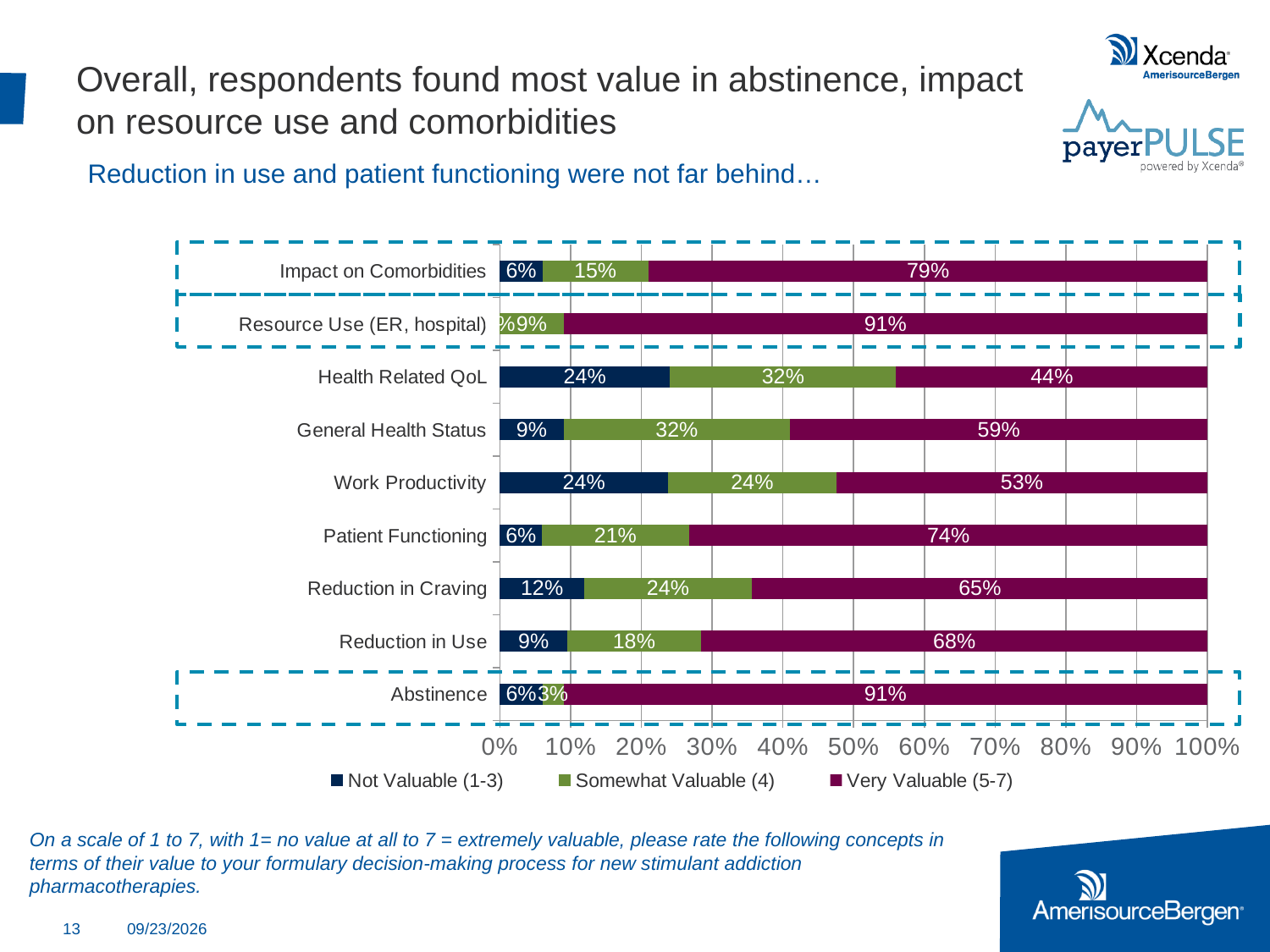
How many series does the legend list? 3 What type of chart is shown on the slide? Stacked bar chart How many concepts are shown in the chart? 9 What percentage of respondents rated Abstinence as Very Valuable (5-7)? 91% What percentage of respondents rated Patient Functioning as Somewhat Valuable (4)? 21% What percentage of respondents rated Impact on Comorbidities as Very Valuable (5-7)? 79% Which has a higher Very Valuable (5-7) percentage: General Health Status or Work Productivity? General Health Status What percentage of respondents rated Health Related QoL as Not Valuable (1-3)? 24% What is the difference in Very Valuable (5-7) percentage between Reduction in Use and Reduction in Craving? 3 percentage points Is the Not Valuable (1-3) value for Resource Use (ER, hospital) greater or less than 10%? less Which concept has the lowest Somewhat Valuable (4) percentage? Abstinence Which concept has the lowest Very Valuable (5-7) percentage? Health Related QoL